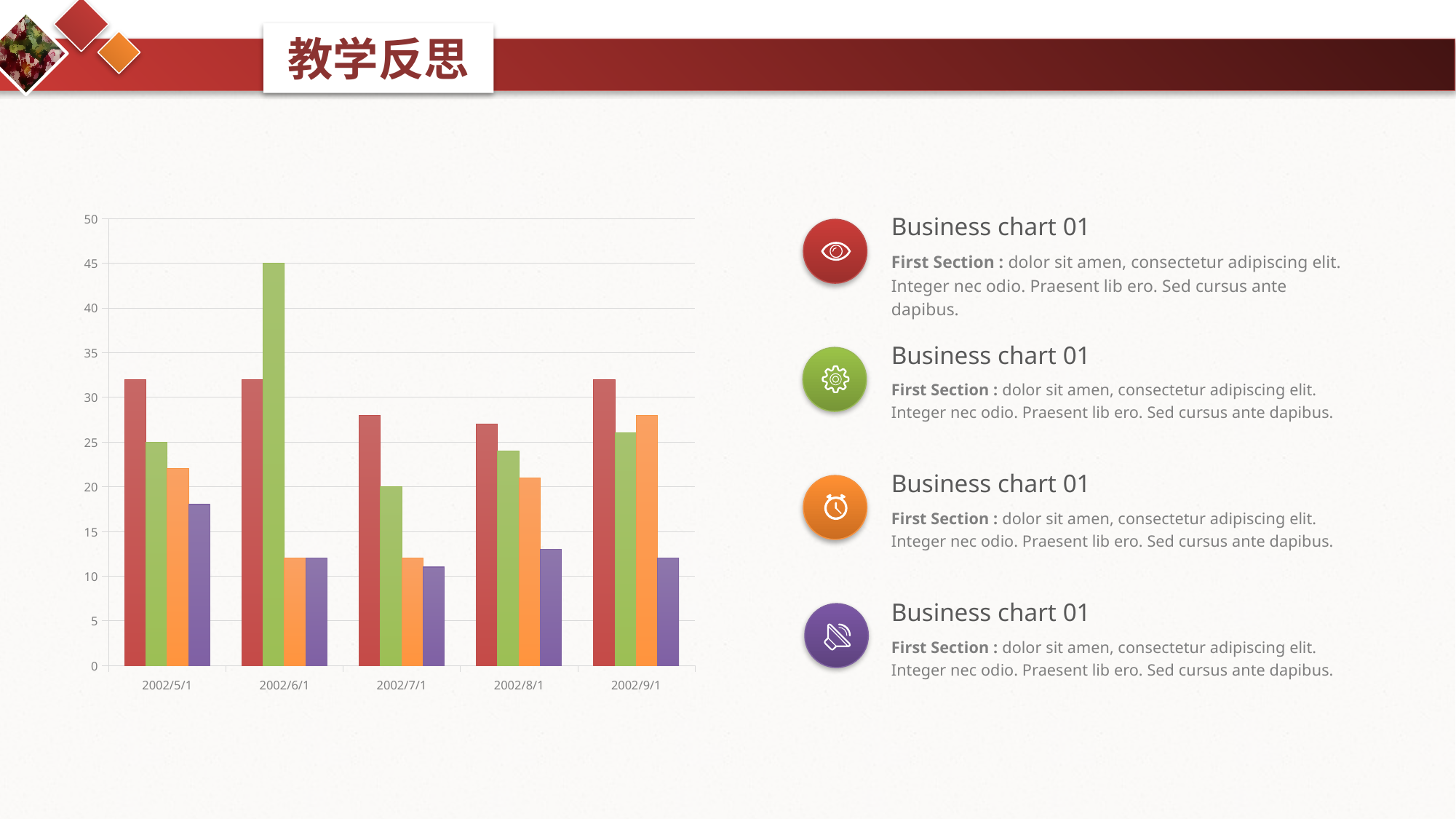
Is the value of the orange bar for 2002/9/1 greater or less than 25? greater For 2002/6/1, which is larger: the green bar or the red bar? the green bar What is the value of the green bar for 2002/6/1? 45 Which date category has the tallest bar in the chart? 2002/6/1 How many bars are plotted for each date category in the chart? 4 How many date categories are shown on the x axis of the chart? 5 What kind of chart is shown on the slide? bar chart Is the value of the red bar for 2002/5/1 greater or less than 30? greater Is the value of the orange bar for 2002/6/1 greater or less than 15? less Which is larger: the purple bar for 2002/5/1 or the purple bar for 2002/6/1? the purple bar for 2002/5/1 What is the value of the green bar for 2002/5/1? 25